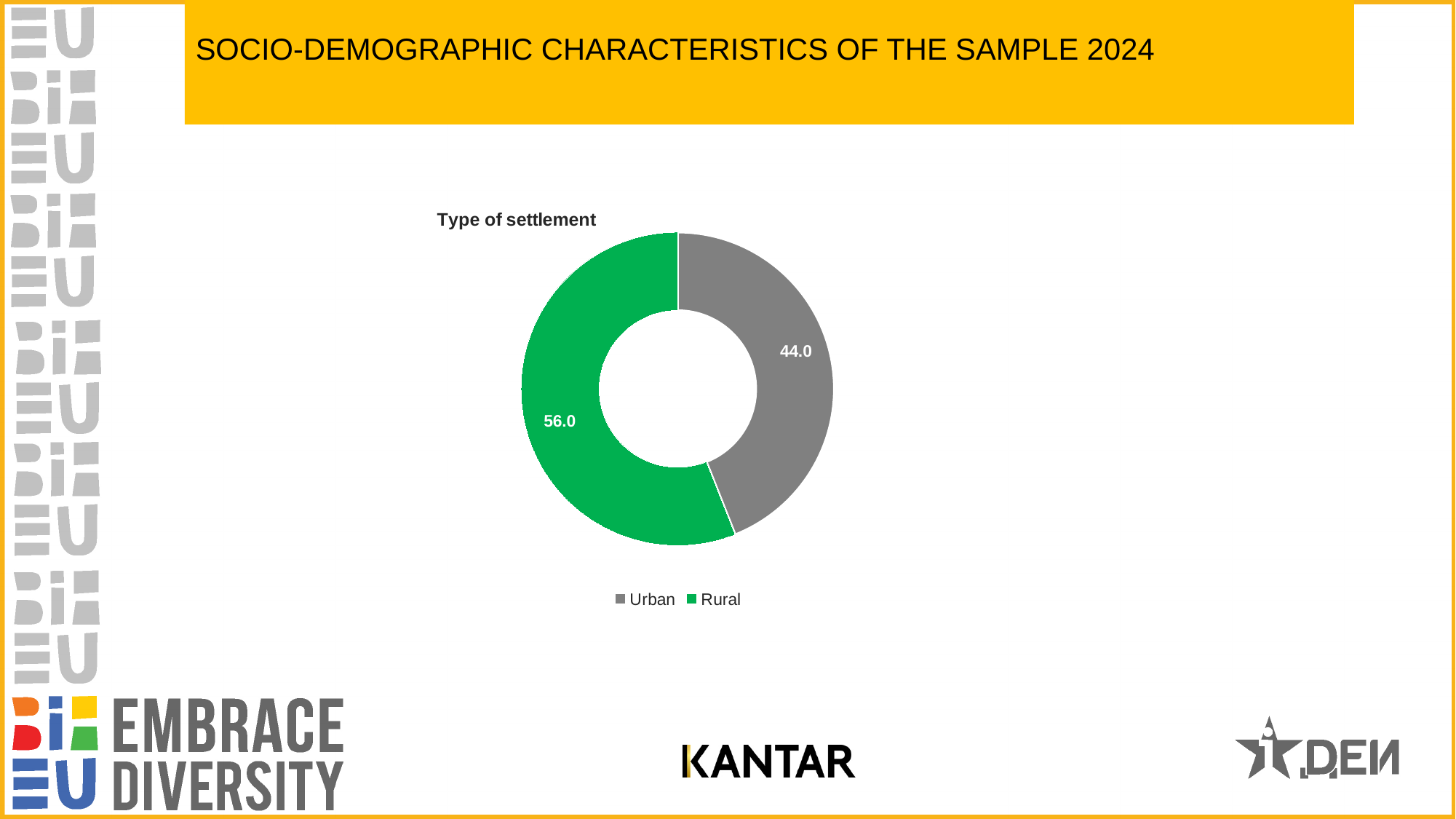
What is the value for Urban in the Type of settlement chart? 44.0 Which is larger in the Type of settlement chart, Urban or Rural? Rural What is the title of the chart on the slide? Type of settlement What kind of chart is the Type of settlement chart? Doughnut (pie) chart How many entries does the legend of the Type of settlement chart list? 2 What is the total of the two values shown in the Type of settlement chart? 100.0 What is the difference between the Rural and Urban values in the Type of settlement chart? 12.0 Which category has the smallest share in the Type of settlement chart? Urban How many categories are shown in the Type of settlement chart? 2 Which category has the largest share in the Type of settlement chart? Rural What colour represents Rural in the Type of settlement chart? Green What is the value for Rural in the Type of settlement chart? 56.0